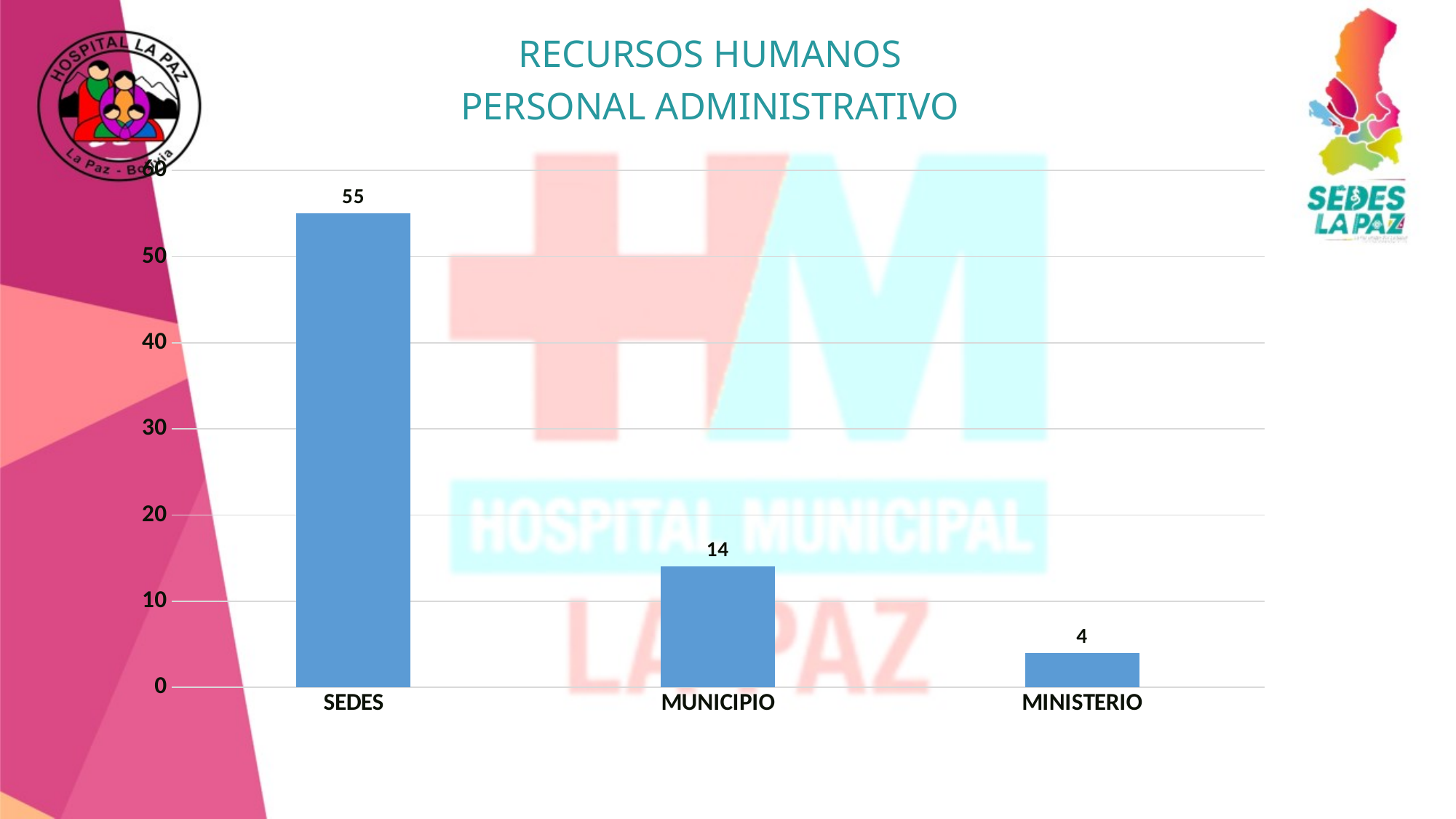
What is the difference between the values for SEDES and MUNICIPIO? 41 Which is larger, the value for MUNICIPIO or the value for MINISTERIO? MUNICIPIO Which category has the highest value? SEDES How many categories are shown on the x axis? 3 What kind of chart is shown on the slide? bar chart What is the title shown above the chart? RECURSOS HUMANOS PERSONAL ADMINISTRATIVO What is the value for MINISTERIO? 4 What is the value for MUNICIPIO? 14 Which category has the lowest value? MINISTERIO What is the value for SEDES? 55 What is the difference between the values for MUNICIPIO and MINISTERIO? 10 Is the value for SEDES greater or less than 50? greater